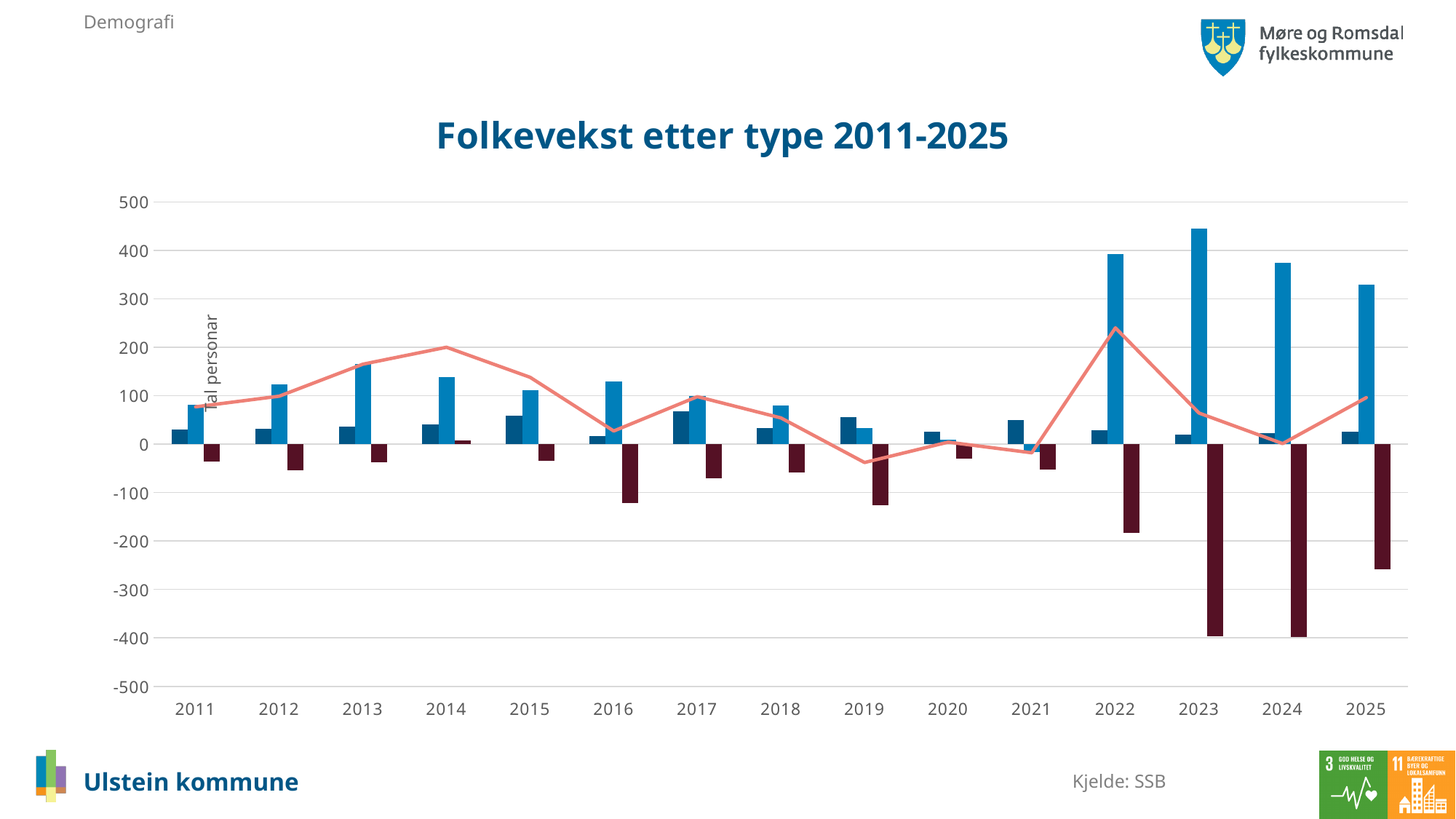
Does the line rise or fall from 2011 to 2014? rise Is the light blue bar for 2025 greater or less than 300? greater What is the label on the vertical axis of the chart? Tal personar Is the dark red bar for 2022 greater or less than -100? less Is the light blue bar for 2023 greater or less than 400? greater In which year is the light blue bar the highest? 2023 What kind of chart is shown on the slide? A bar chart with a line How many years are shown along the x axis of the chart? 15 Which year has the larger light blue bar, 2012 or 2013? 2013 What is the title of the chart? Folkevekst etter type 2011-2025